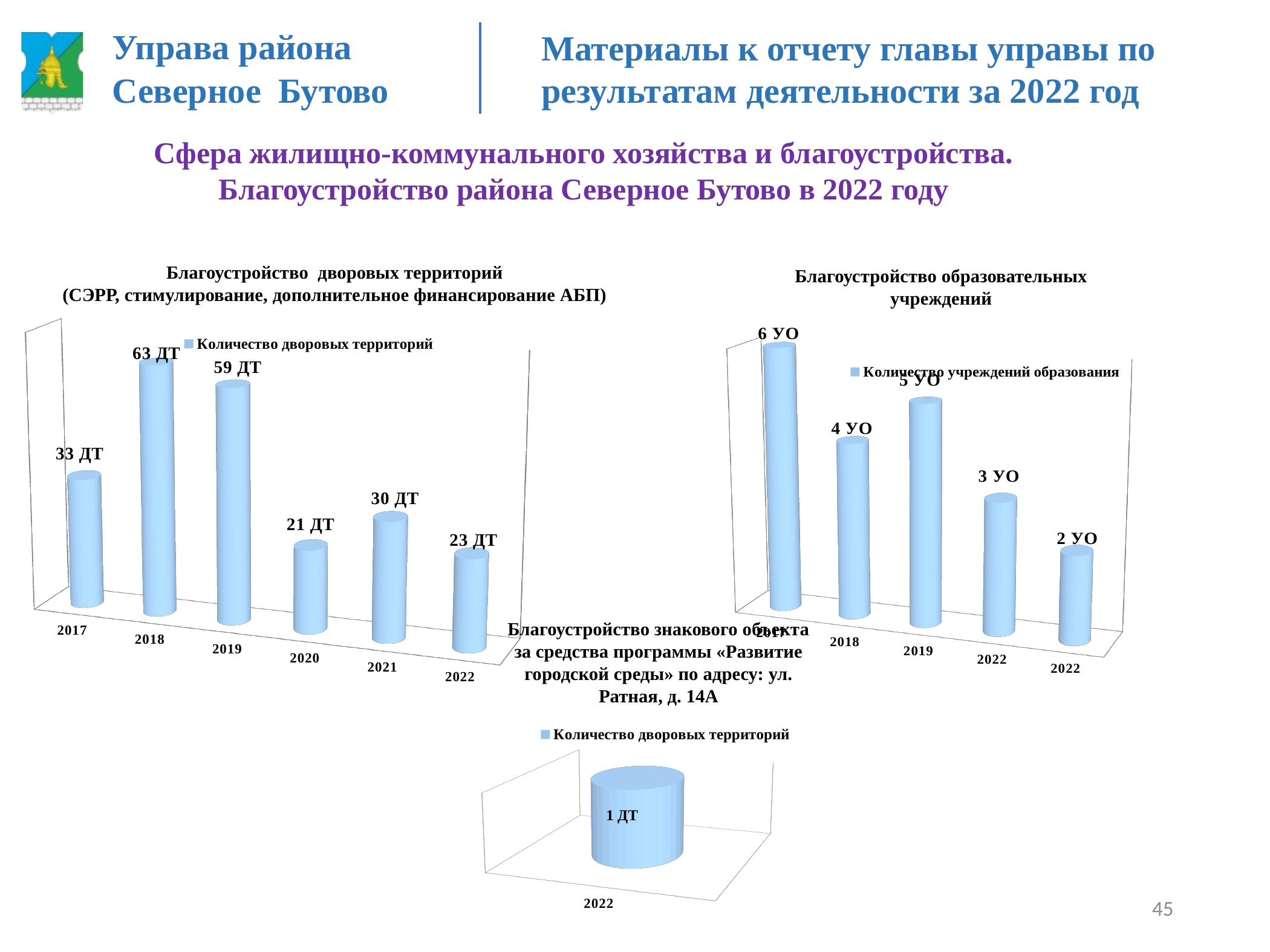
In the chart 'Благоустройство образовательных учреждений', what is the highest value shown? 6 УО What kind of chart is 'Благоустройство образовательных учреждений'? Bar chart In the chart 'Благоустройство дворовых территорий', what is the value for 2022? 23 ДТ In the chart 'Благоустройство дворовых территорий', which is larger: the value for 2021 or the value for 2022? 2021 In the chart 'Благоустройство дворовых территорий', which year has the highest value? 2018 In the chart 'Благоустройство дворовых территорий', which year has the lowest value? 2020 In the chart 'Благоустройство образовательных учреждений', what is the value for 2019? 5 УО In the chart 'Благоустройство дворовых территорий', what is the value for 2018? 63 ДТ In the chart 'Благоустройство дворовых территорий', what is the difference between the values for 2018 and 2019? 4 ДТ In the chart 'Благоустройство знакового объекта' at the bottom of the slide, what is the value for 2022? 1 ДТ In the chart 'Благоустройство образовательных учреждений', what is the value for 2018? 4 УО How many years are shown on the x axis of the chart 'Благоустройство дворовых территорий'? 6